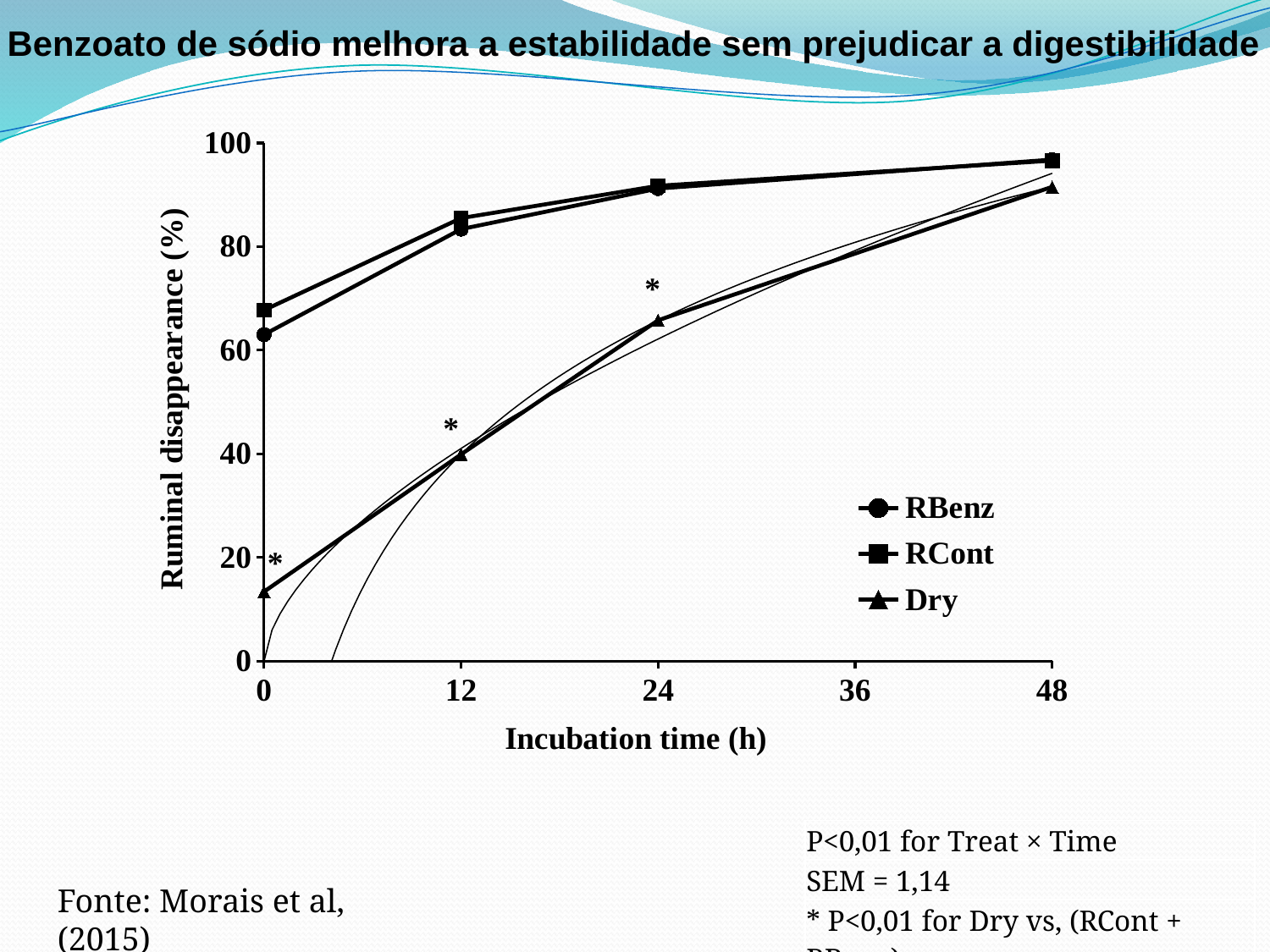
Which series has the lowest ruminal disappearance at 0 h? Dry What kind of chart is shown on the slide? Line chart How many incubation time points are plotted for the Dry series? 4 Which series has the highest ruminal disappearance at 0 h? RCont At 24 h, which is larger: the value for RBenz or the value for Dry? RBenz Is the value for Dry at 24 h greater or less than 60? greater Does the ruminal disappearance for the Dry series rise or fall as incubation time increases? Rise Is the value for RCont at 12 h greater or less than 80? greater Which series are listed in the legend? RBenz, RCont, Dry How many series does the legend list? 3 Is the value for Dry at 0 h greater or less than 20? less What is the title of the y axis? Ruminal disappearance (%)